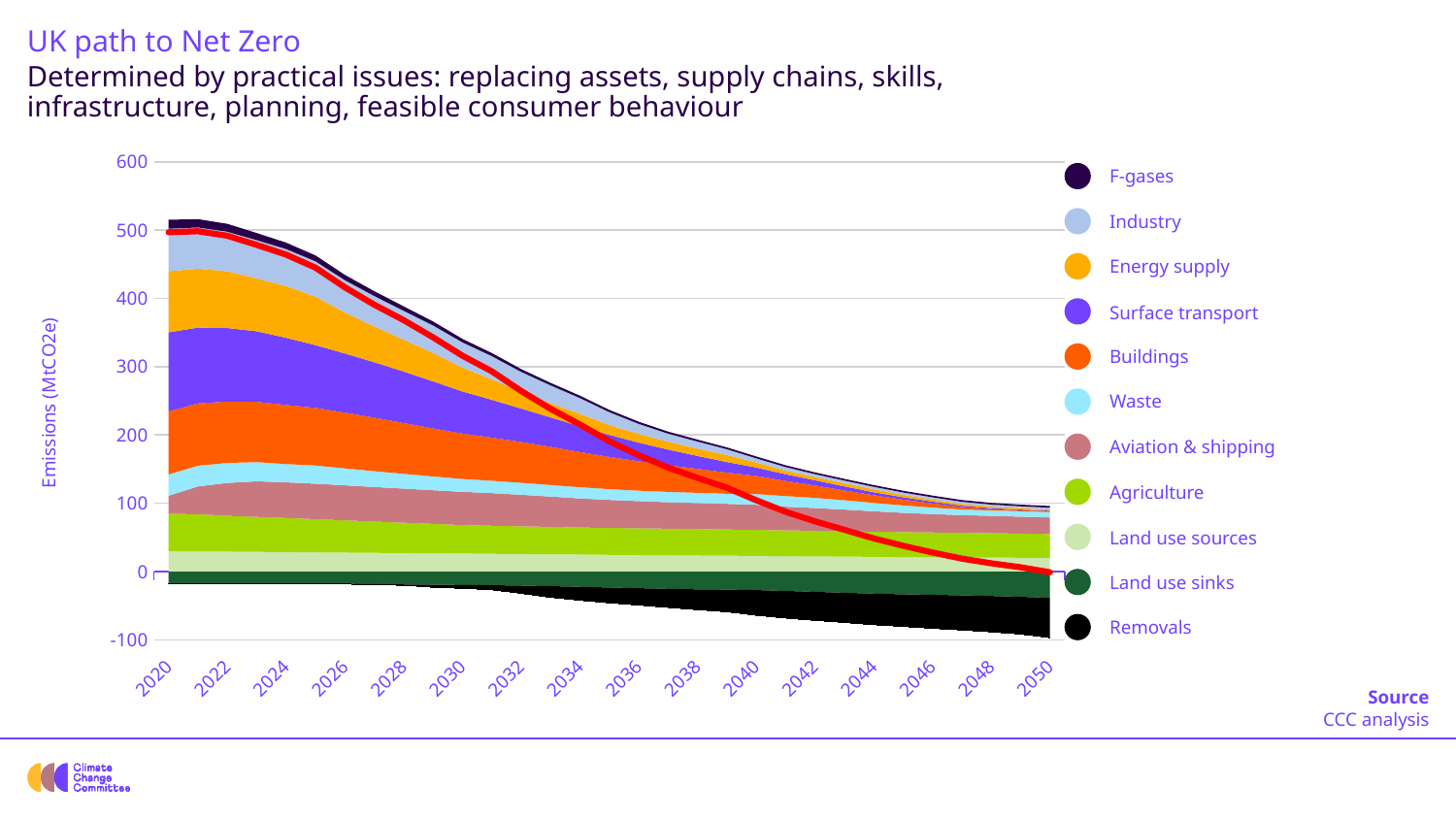
Is the value of the red line in 2036 greater or less than 300? less Is the value of the red line in 2040 greater or less than 200? less Does the red line rise or fall from 2020 to 2050? Fall How many year labels are shown on the x axis? 16 What is the lowest value shown on the y axis? -100 What is the label of the y axis? Emissions (MtCO2e) Is the value of the red line in 2050 greater or less than 100? less What kind of chart is shown on the slide? Stacked area chart Which series is listed first in the legend? F-gases Does the Removals area grow or shrink in size from 2020 to 2050? Grow How many series does the legend list? 11